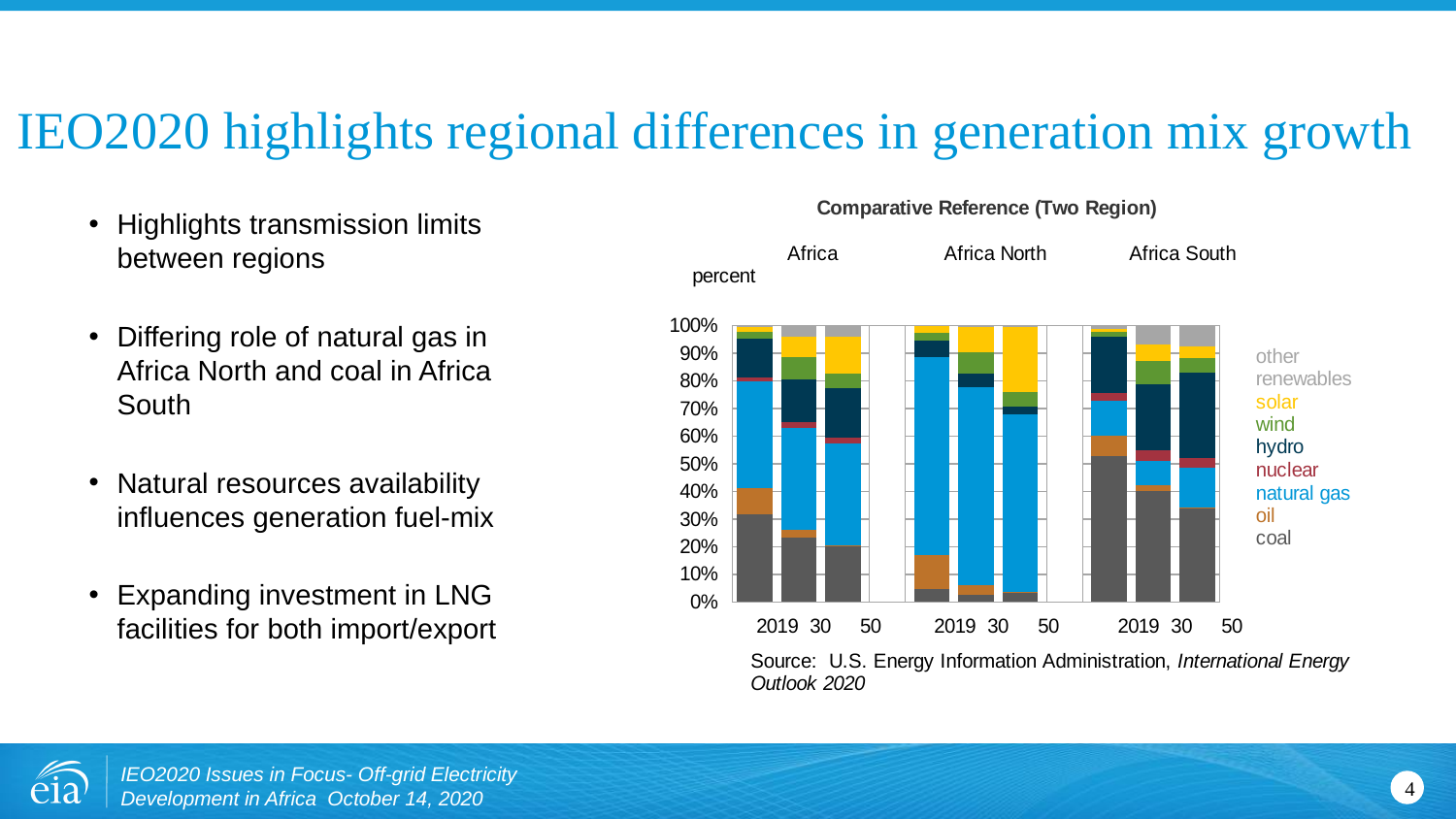
What kind of chart is shown on the slide? stacked bar chart Does the coal share for Africa South rise or fall from 2019 to 2050? fall Does the solar share for Africa North rise or fall from 2019 to 2050? rise Is the coal share for Africa in 2019 greater or less than 40%? less What is the title of the chart? Comparative Reference (Two Region) How many regions are shown in the chart? 3 Is the coal share for Africa North in 2019 greater or less than 10%? less Which region has the larger coal share in 2019, Africa North or Africa South? Africa South Is the coal share for Africa South in 2019 greater or less than 40%? greater How many fuel types does the legend of the chart list? 8 How many bars are plotted in the chart in total? 9 Which fuel is shown at the bottom of each stacked bar? coal